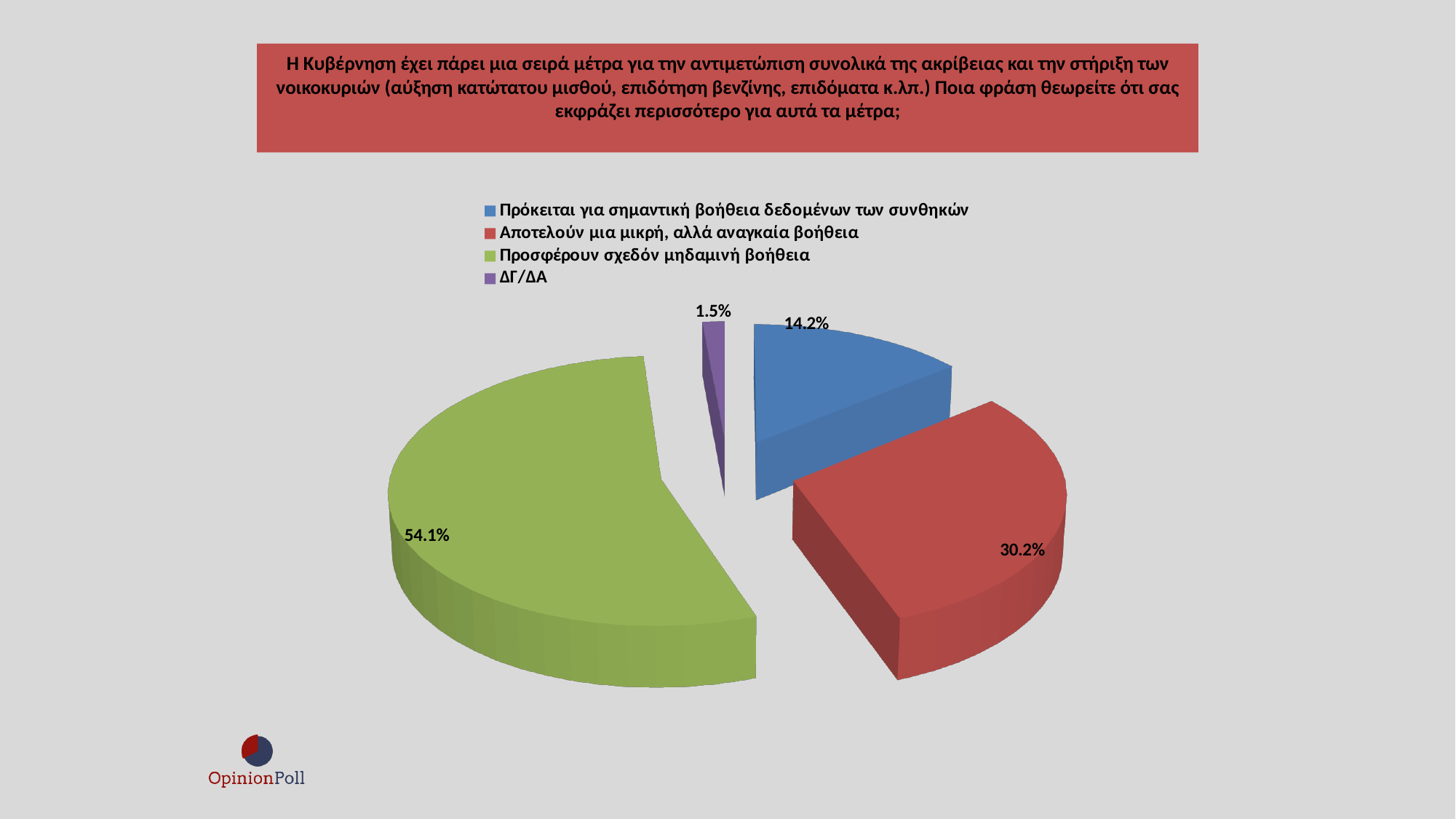
What is the difference in percentage points between "Προσφέρουν σχεδόν μηδαμινή βοήθεια" and "Αποτελούν μια μικρή, αλλά αναγκαία βοήθεια"? 23.9 What kind of chart is shown on the slide? Pie chart Which is larger: the share for "Αποτελούν μια μικρή, αλλά αναγκαία βοήθεια" or for "Πρόκειται για σημαντική βοήθεια δεδομένων των συνθηκών"? Αποτελούν μια μικρή, αλλά αναγκαία βοήθεια Which response has the largest share of the pie? Προσφέρουν σχεδόν μηδαμινή βοήθεια What colour is the slice for "Προσφέρουν σχεδόν μηδαμινή βοήθεια"? Green What percentage of respondents chose "Προσφέρουν σχεδόν μηδαμινή βοήθεια"? 54.1% Which response has the smallest share of the pie? ΔΓ/ΔΑ What percentage of respondents answered "ΔΓ/ΔΑ"? 1.5% What percentage of respondents chose "Αποτελούν μια μικρή, αλλά αναγκαία βοήθεια"? 30.2% How many entries does the legend list? 4 What percentage of respondents chose "Πρόκειται για σημαντική βοήθεια δεδομένων των συνθηκών"? 14.2% How many slices does the pie chart have? 4